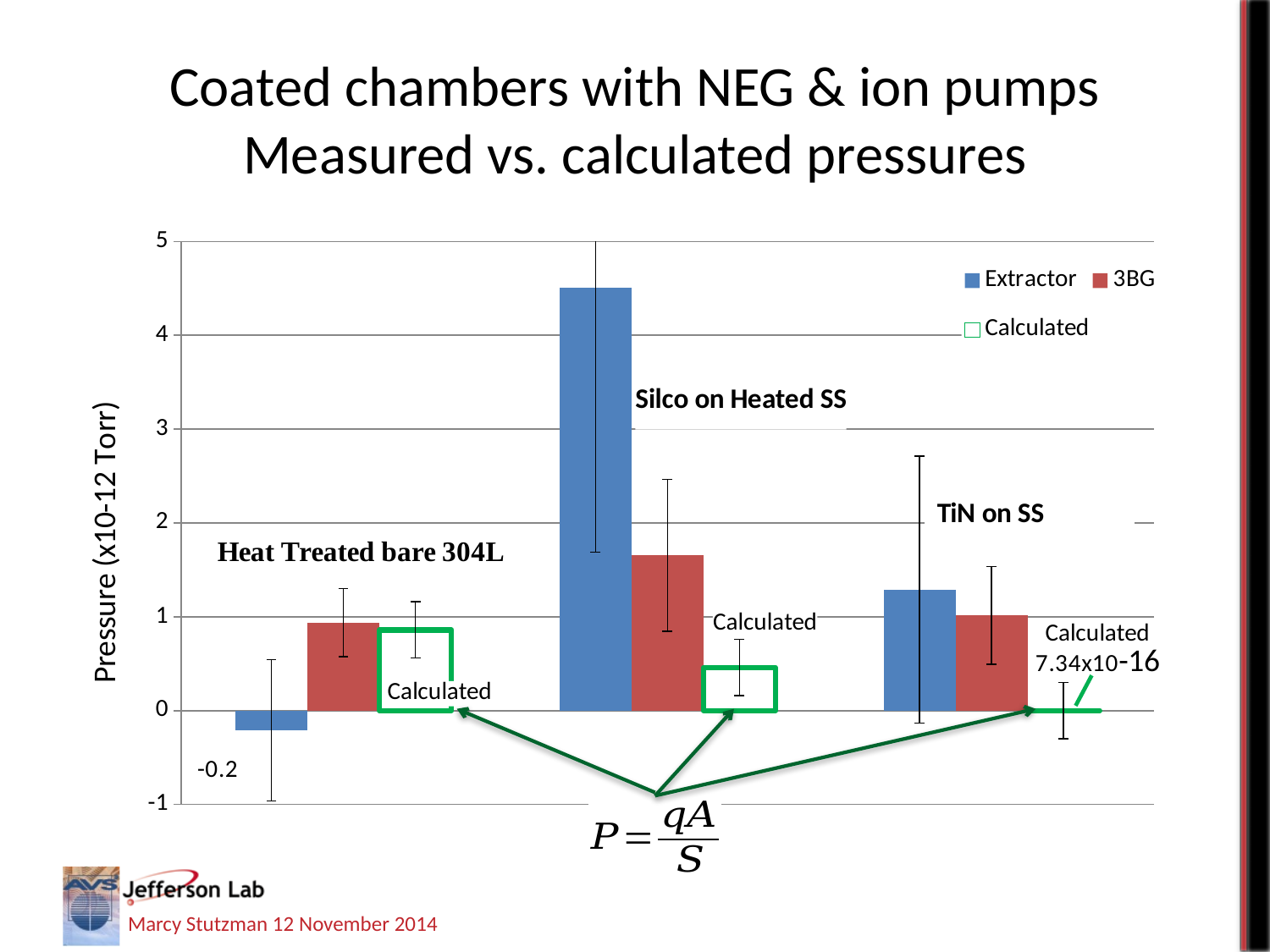
Is the 3BG value for Silco on Heated SS greater or less than 2? less What type of chart is shown on the slide? bar chart Which category has the highest Extractor bar? Silco on Heated SS What is the Extractor value for Heat Treated bare 304L? -0.2 How many chamber categories are shown on the x axis of the chart? 3 How many series does the chart legend list? 3 For Silco on Heated SS, which is larger, the Extractor value or the 3BG value? Extractor Which category has the lowest Extractor bar? Heat Treated bare 304L What is the label of the chart's y axis? Pressure (x10-12 Torr) For Heat Treated bare 304L, which is larger, the Extractor value or the 3BG value? 3BG Is the Extractor value for Silco on Heated SS greater or less than 4? greater Is the Calculated value for Silco on Heated SS greater or less than 1? less